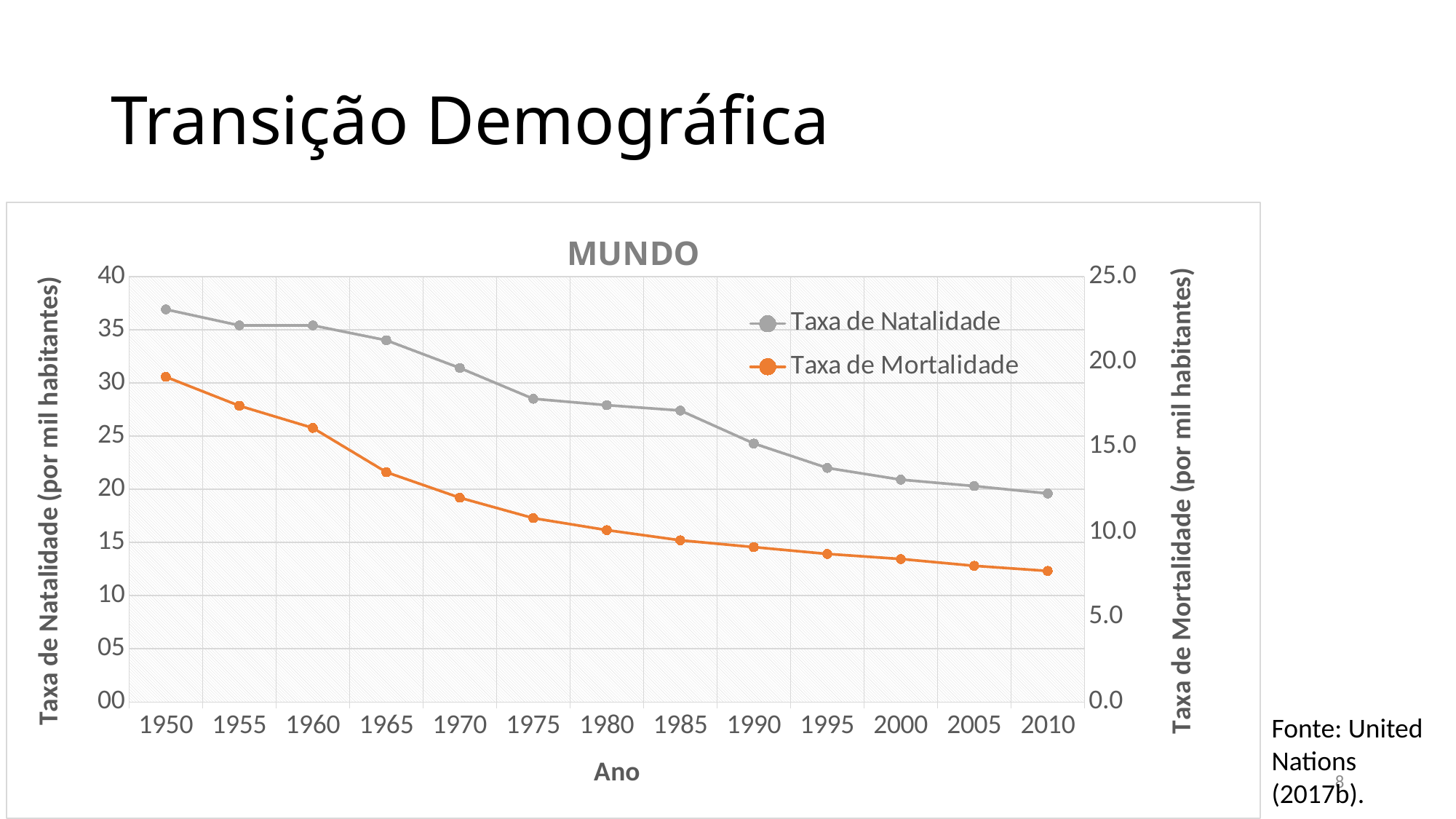
Does the Taxa de Mortalidade rise or fall from 1950 to 2010? fall What is the title of the chart? MUNDO Is the Taxa de Natalidade in 1950 greater or less than 35 on the left axis? greater Does the Taxa de Natalidade rise or fall from 1950 to 2010? fall Which series is drawn in orange? Taxa de Mortalidade In which year is the Taxa de Natalidade highest? 1950 Is the Taxa de Mortalidade in 2010 greater or less than 10.0 on the right axis? less In which year is the Taxa de Natalidade lowest? 2010 How many years (data points) are plotted along the x axis? 13 What kind of chart is shown on the slide? line chart How many series does the legend list? 2